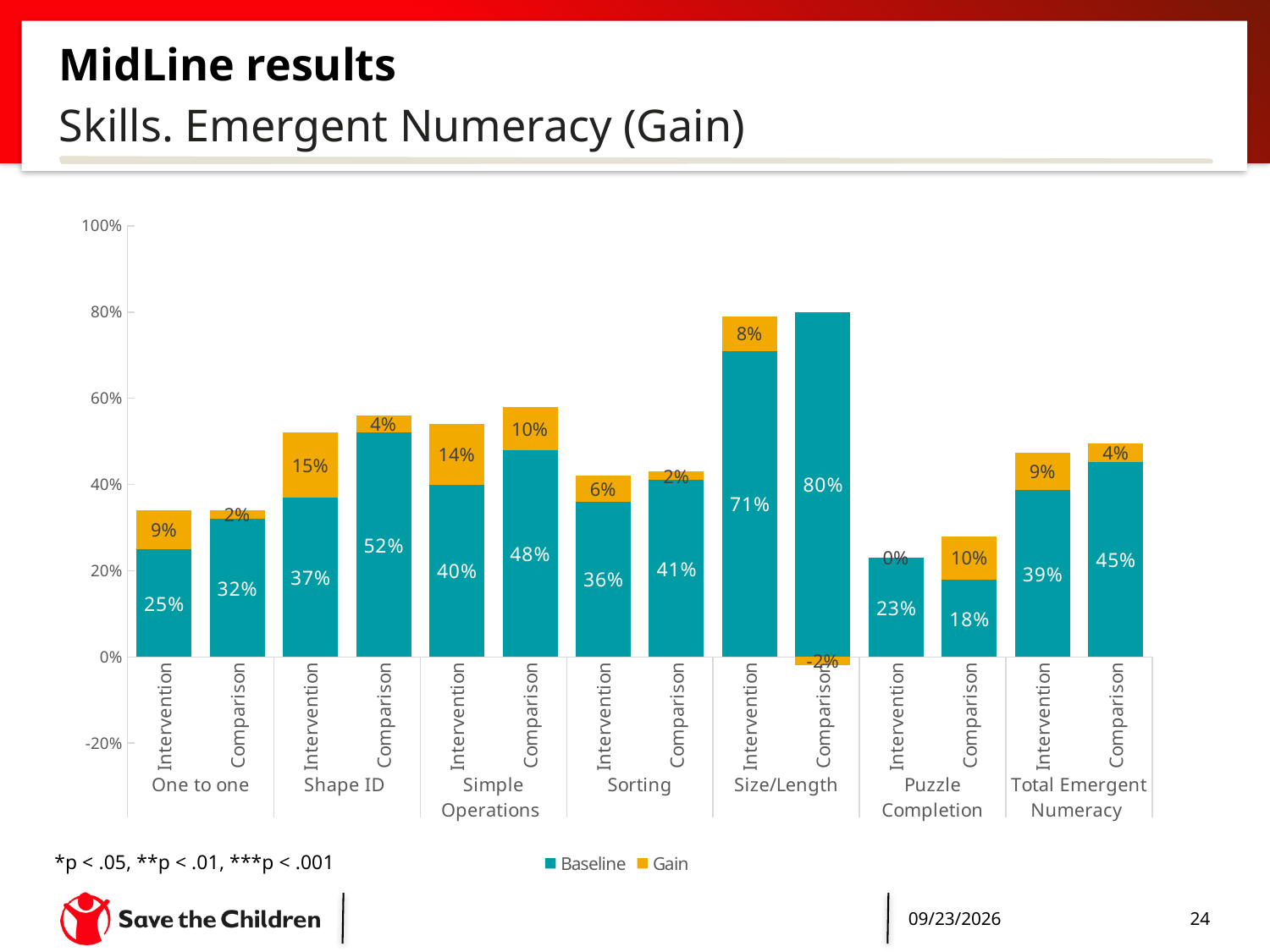
What is the total height (Baseline plus Gain) of the Intervention bar under Total Emergent Numeracy? 48% Which is larger: the Baseline for Intervention or for Comparison under Puzzle Completion? Intervention (23%) Which bar has the lowest Baseline value? Puzzle Completion Comparison (18%) What is the Gain value for the Comparison bar under Simple Operations? 10% What kind of chart is shown on the slide? Stacked bar chart Which colour represents the Gain series in the legend? Orange/yellow What is the difference between the Gain for Intervention and the Gain for Comparison under Shape ID? 11% What is the Baseline value for the Intervention bar under Shape ID? 37% How many bars are plotted in the chart? 14 Which bar has the highest Baseline value? Size/Length Comparison (80%) How many series does the legend list? 2 What is the Gain value for the Comparison bar under Size/Length? -2%